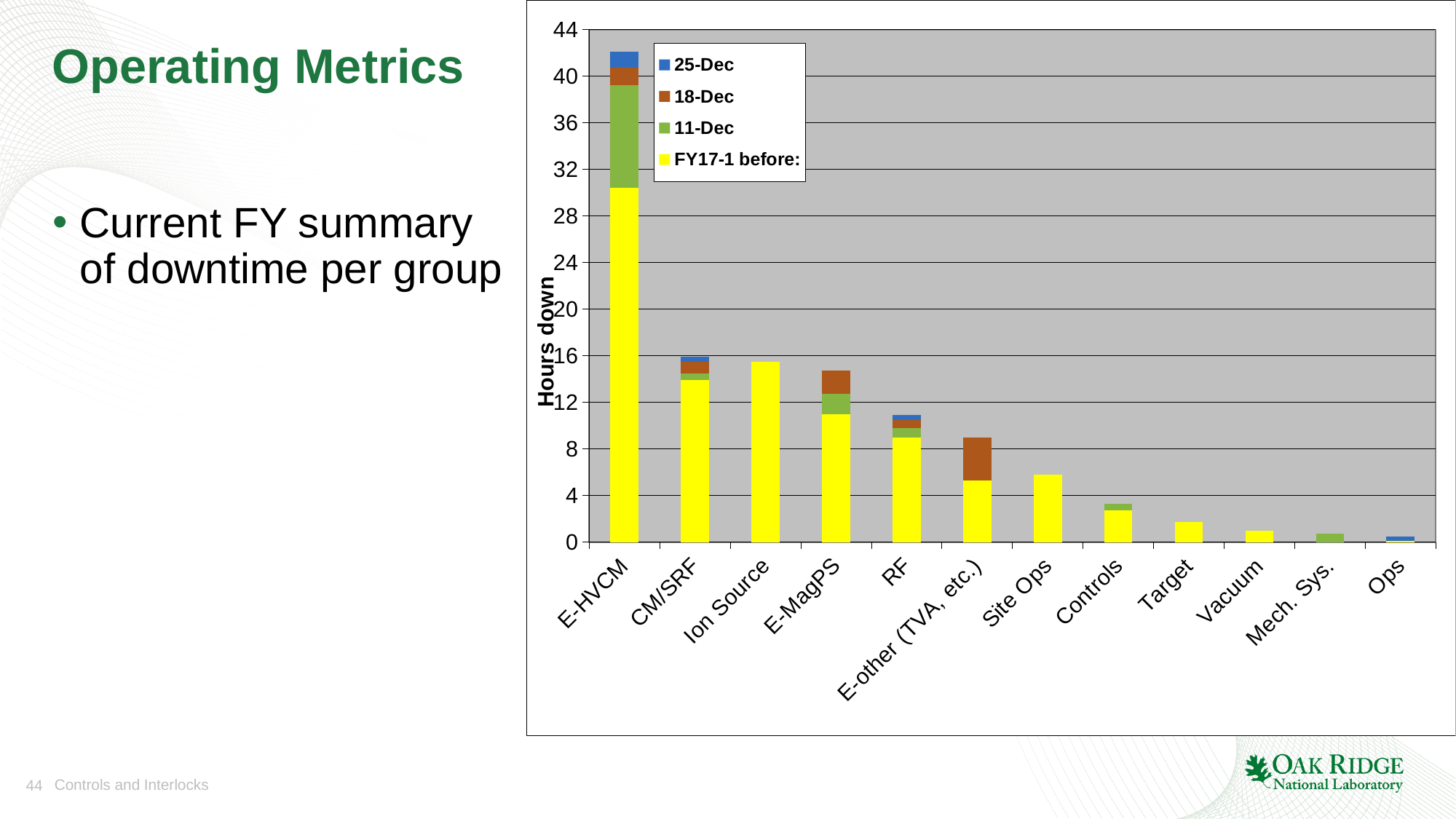
Is the total value for Controls greater or less than 4? less Which has more total hours down, Site Ops or Controls? Site Ops How many series does the chart's legend list? 4 What is the label on the chart's vertical axis? Hours down Do the total bar heights generally rise or fall moving left to right along the x axis? fall What kind of chart is shown on the slide? bar chart Is the total value for RF greater or less than 12? less Is the value for Ion Source greater or less than 16? less Which group has the highest total hours down? E-HVCM How many groups (categories) are shown on the x axis of the chart? 12